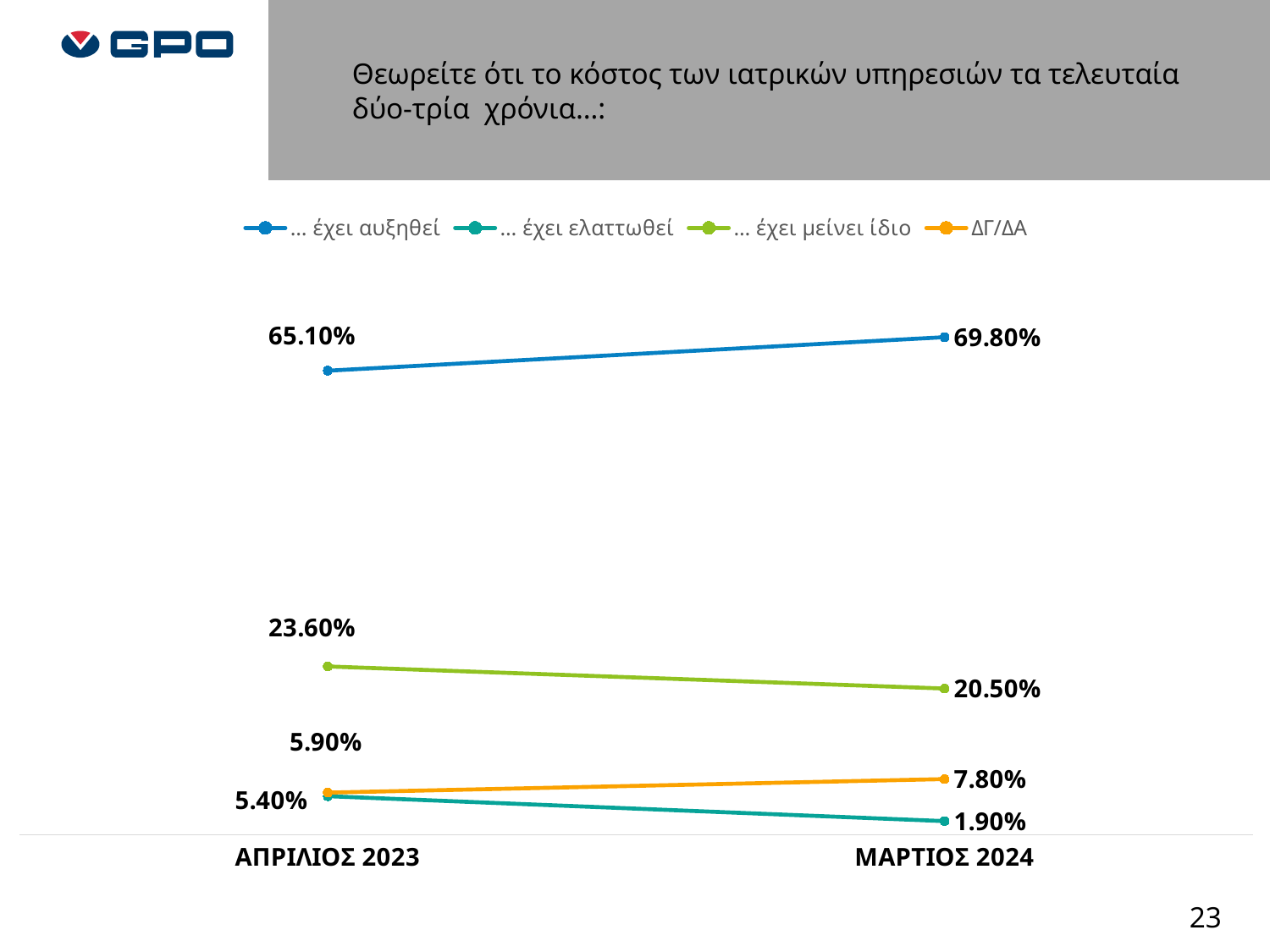
By how much did "... έχει αυξηθεί" change from ΑΠΡΙΛΙΟΣ 2023 to ΜΑΡΤΙΟΣ 2024? 4.70% What is the value for "... έχει αυξηθεί" in ΑΠΡΙΛΙΟΣ 2023? 65.10% What is the value for "... έχει μείνει ίδιο" in ΜΑΡΤΙΟΣ 2024? 20.50% Which series has the highest value in ΜΑΡΤΙΟΣ 2024? ... έχει αυξηθεί Does the value for "... έχει μείνει ίδιο" rise or fall from ΑΠΡΙΛΙΟΣ 2023 to ΜΑΡΤΙΟΣ 2024? fall How many time points are shown on the x axis? 2 What is the value for "... έχει αυξηθεί" in ΜΑΡΤΙΟΣ 2024? 69.80% What is the value for "... έχει ελαττωθεί" in ΜΑΡΤΙΟΣ 2024? 1.90% What is the value for ΔΓ/ΔΑ in ΜΑΡΤΙΟΣ 2024? 7.80% Which series has the lowest value in ΜΑΡΤΙΟΣ 2024? ... έχει ελαττωθεί How many series does the legend list? 4 What type of chart is shown on the slide? line chart